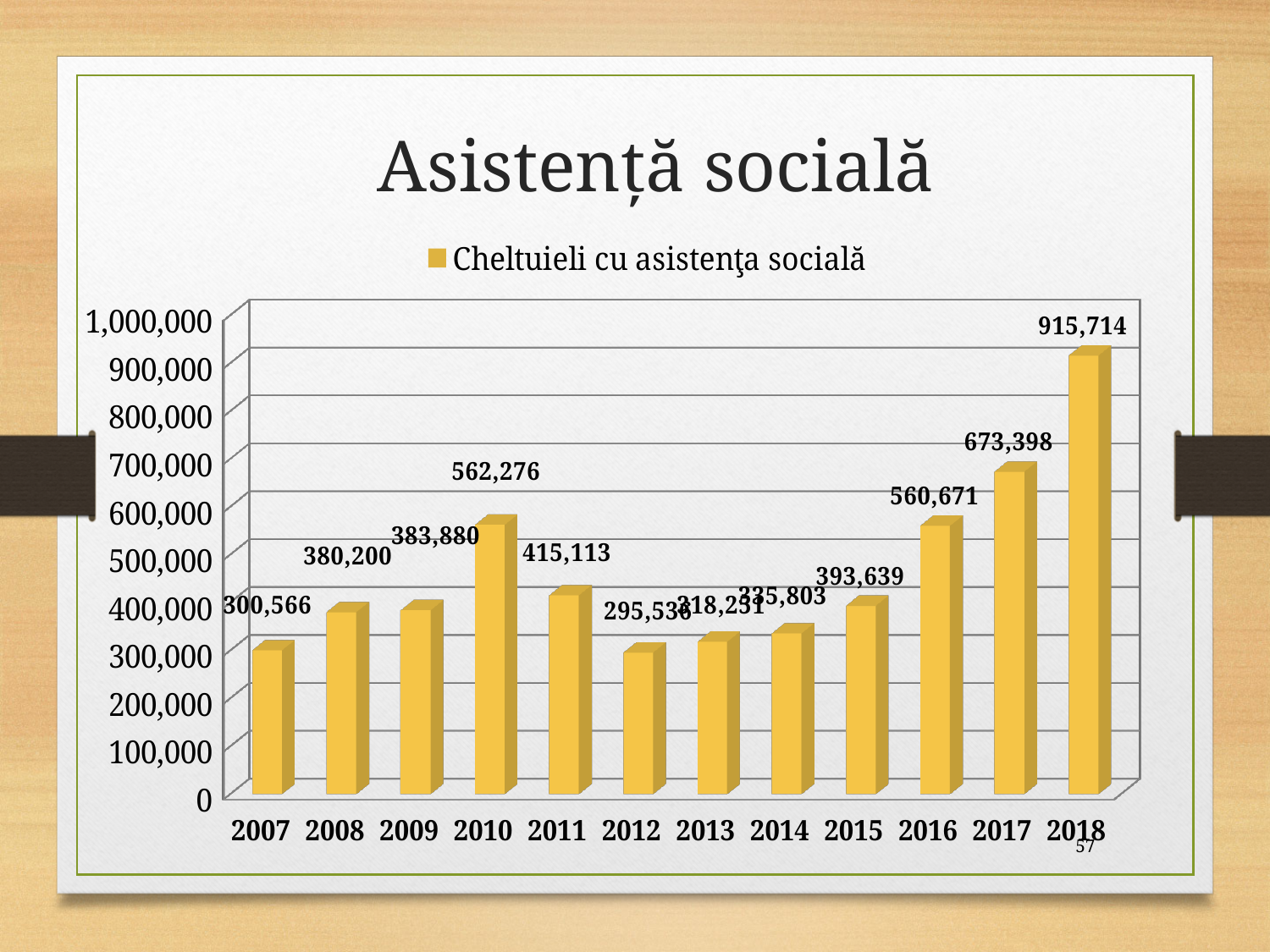
How many years are shown on the x axis? 12 What is the value for 2010? 562,276 What is the difference between the values for 2009 and 2008? 3,680 What is the value for 2018? 915,714 How many series does the legend list? 1 Which year has the highest value? 2018 Do the values rise or fall from 2015 to 2018? rise Is the value for 2017 greater or less than 600,000? greater What kind of chart is shown? bar chart What is the difference between the values for 2018 and 2017? 242,316 Which is larger, the value for 2011 or the value for 2015? 2011 What is the value for 2007? 300,566